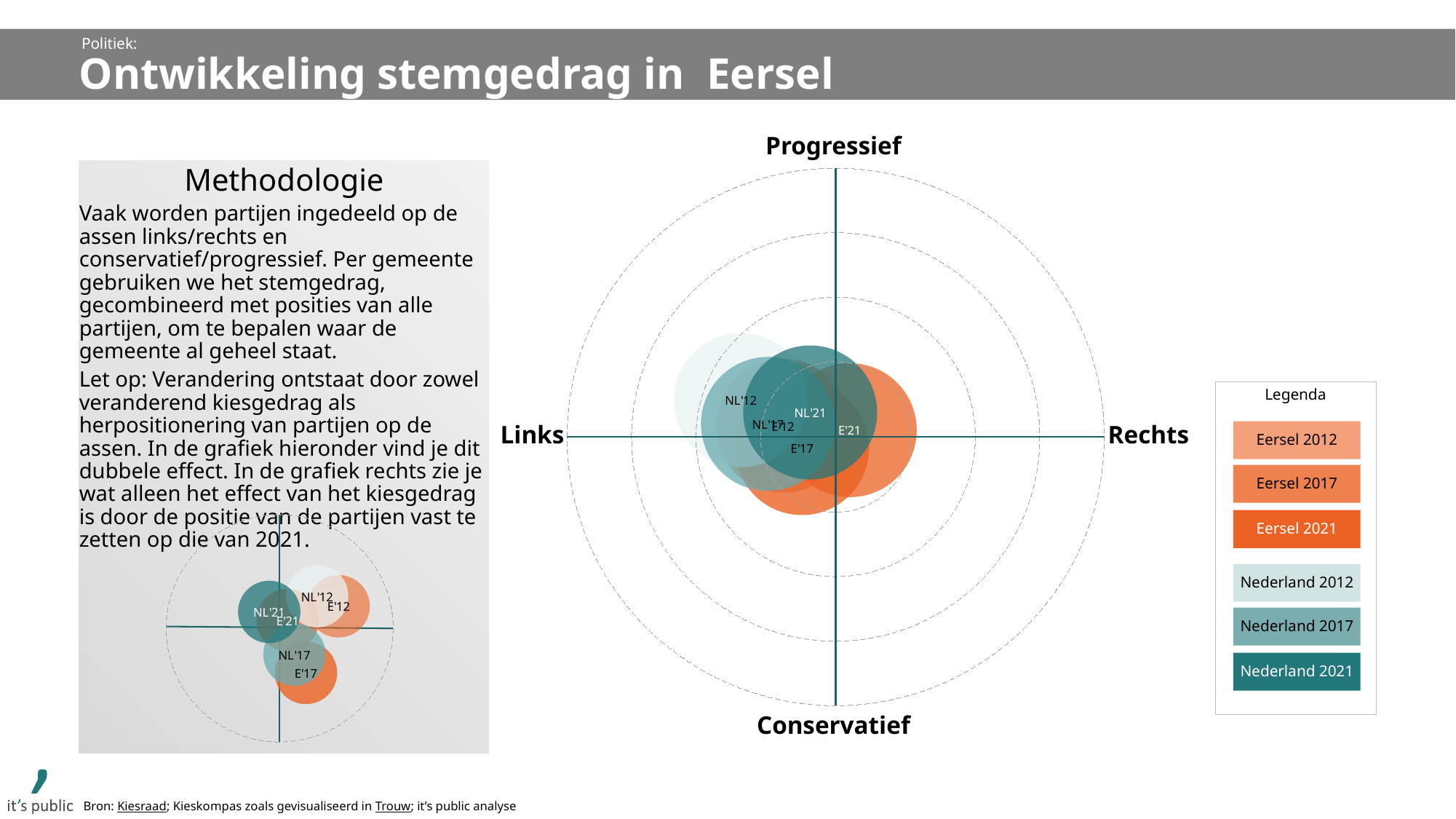
How many labelled bubbles are plotted in the large chart? 6 What kind of chart is the large chart on the right side of the slide? Bubble chart In the large chart, what label is shown at the right end of the horizontal axis? Rechts In the large chart, which bubble lies furthest to the left (most 'Links')? NL'12 In the large chart, which bubble lies lowest (most 'Conservatief')? E'17 In the small chart inside the Methodologie box, which bubble lies furthest to the right? E'12 In the large chart, is the E'21 bubble positioned to the left or to the right of the NL'21 bubble? Right In the small chart inside the Methodologie box, is the NL'21 bubble to the left or to the right of the vertical axis? Left How many entries does the legend (Legenda) list? 6 In the large chart, what label is shown at the top end of the vertical axis? Progressief In the large chart, which bubble lies furthest to the right (most 'Rechts')? E'21